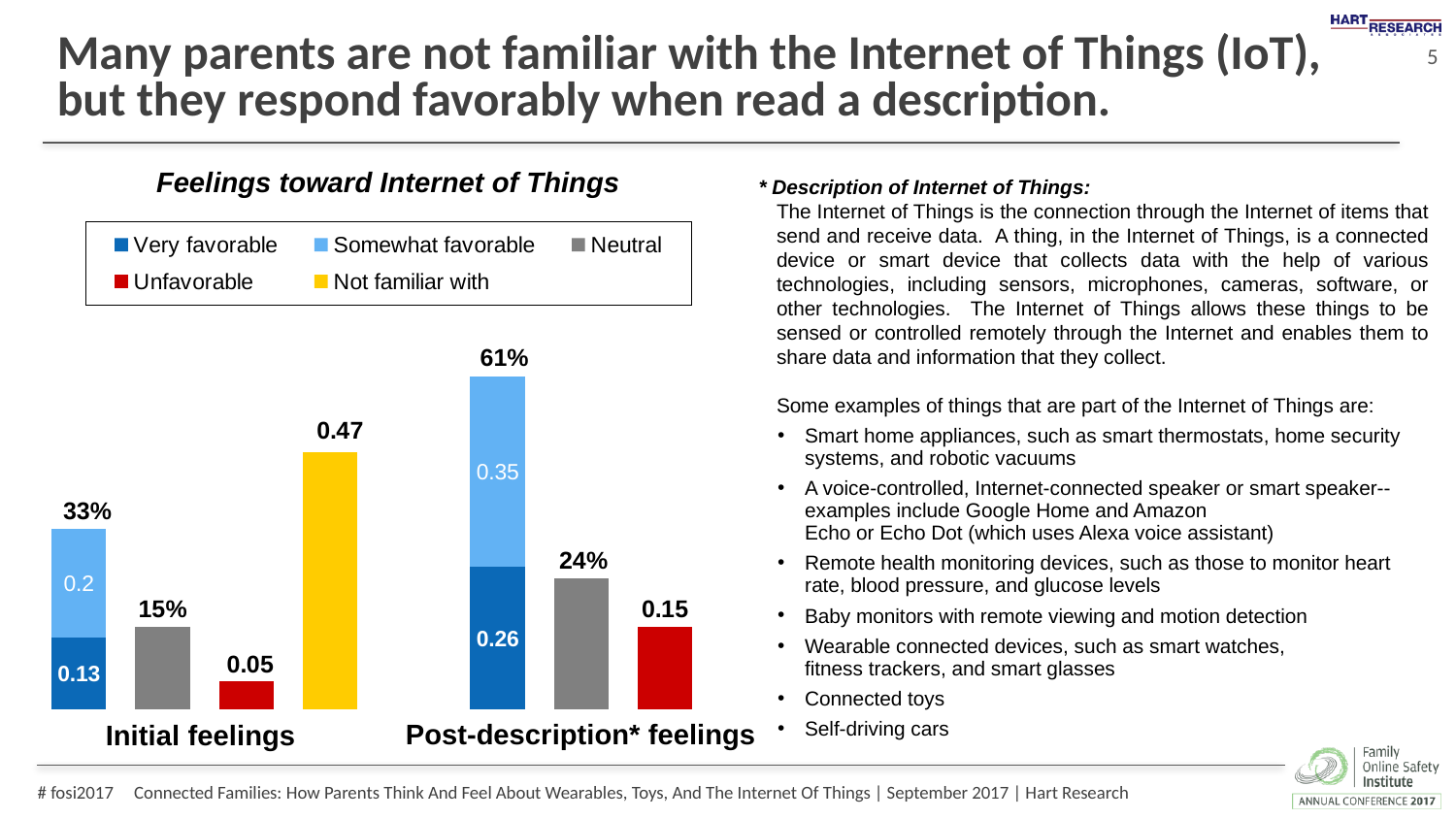
What is the Neutral value for Post-description* feelings? 24% What is the difference between the Unfavorable value for Post-description* feelings and the Unfavorable value for Initial feelings? 0.10 Which series has the lowest value among Initial feelings? Unfavorable Which is larger: the Very favorable value for Initial feelings or the Very favorable value for Post-description* feelings? Post-description* feelings What is the Very favorable value for Initial feelings? 0.13 How many series does the chart's legend list? 5 What is the Not familiar with value for Initial feelings? 0.47 What is the total of the stacked favorable bar (Very favorable plus Somewhat favorable) for Post-description* feelings? 61% What kind of chart is shown on the slide? bar chart What is the Somewhat favorable value for Post-description* feelings? 0.35 Which series has the highest single bar among Initial feelings? Not familiar with What is the title of the chart on the slide? Feelings toward Internet of Things